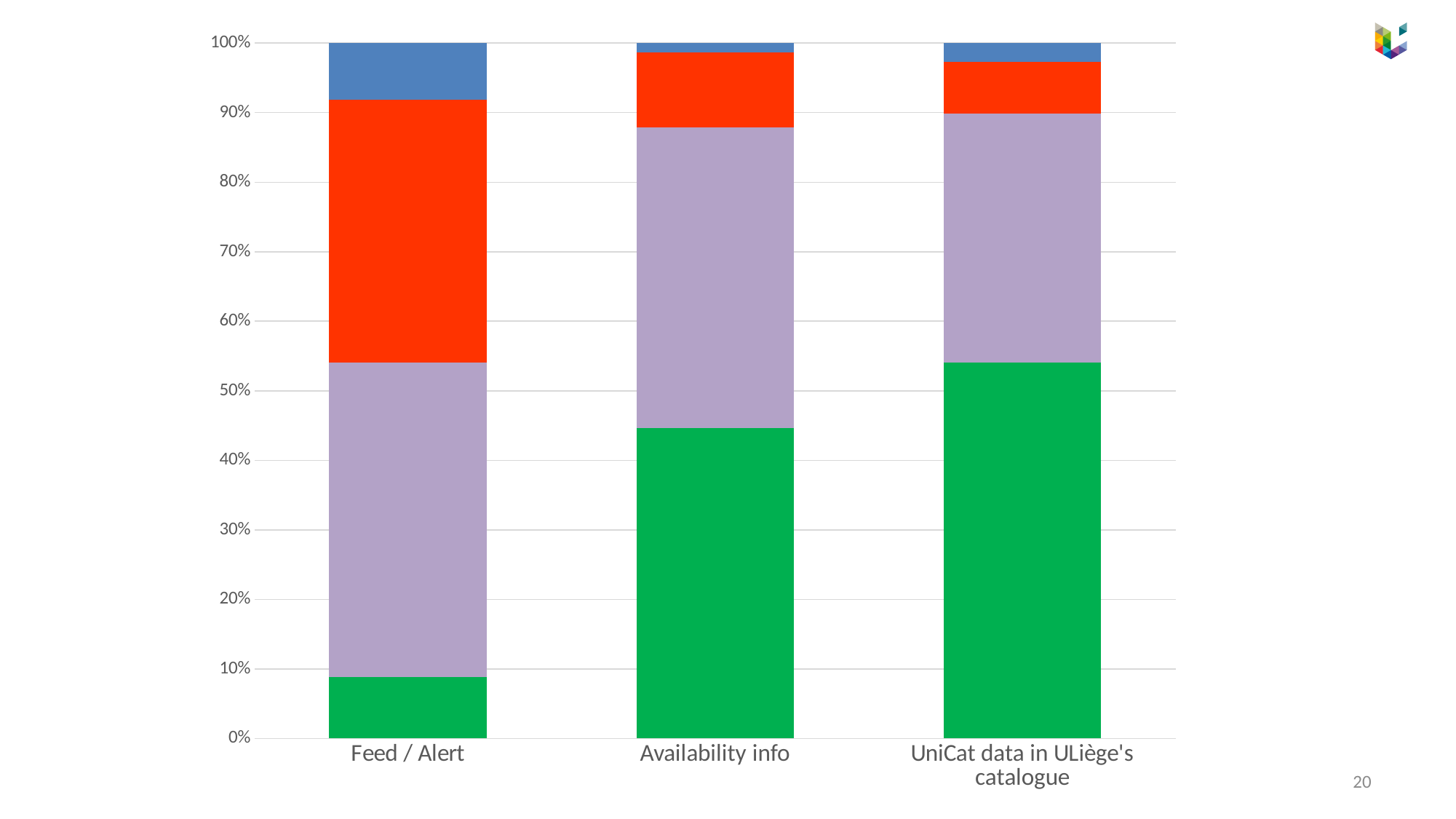
How many categories are shown on the x axis of the chart? 3 Which category has the largest green segment? UniCat data in ULiège's catalogue How many coloured segments make up each bar in the chart? 4 What is the label of the third category on the x axis? UniCat data in ULiège's catalogue Which category has the smallest green segment? Feed / Alert Is the green segment for UniCat data in ULiège's catalogue greater or less than 50%? greater Which category has the largest red segment? Feed / Alert Is the green segment for Availability info greater or less than 50%? less What is the highest value shown on the y axis of the chart? 100% What kind of chart is shown on the slide? Stacked bar chart Is the blue segment larger for Feed / Alert or for Availability info? Feed / Alert Is the green segment for Feed / Alert greater or less than 10%? less